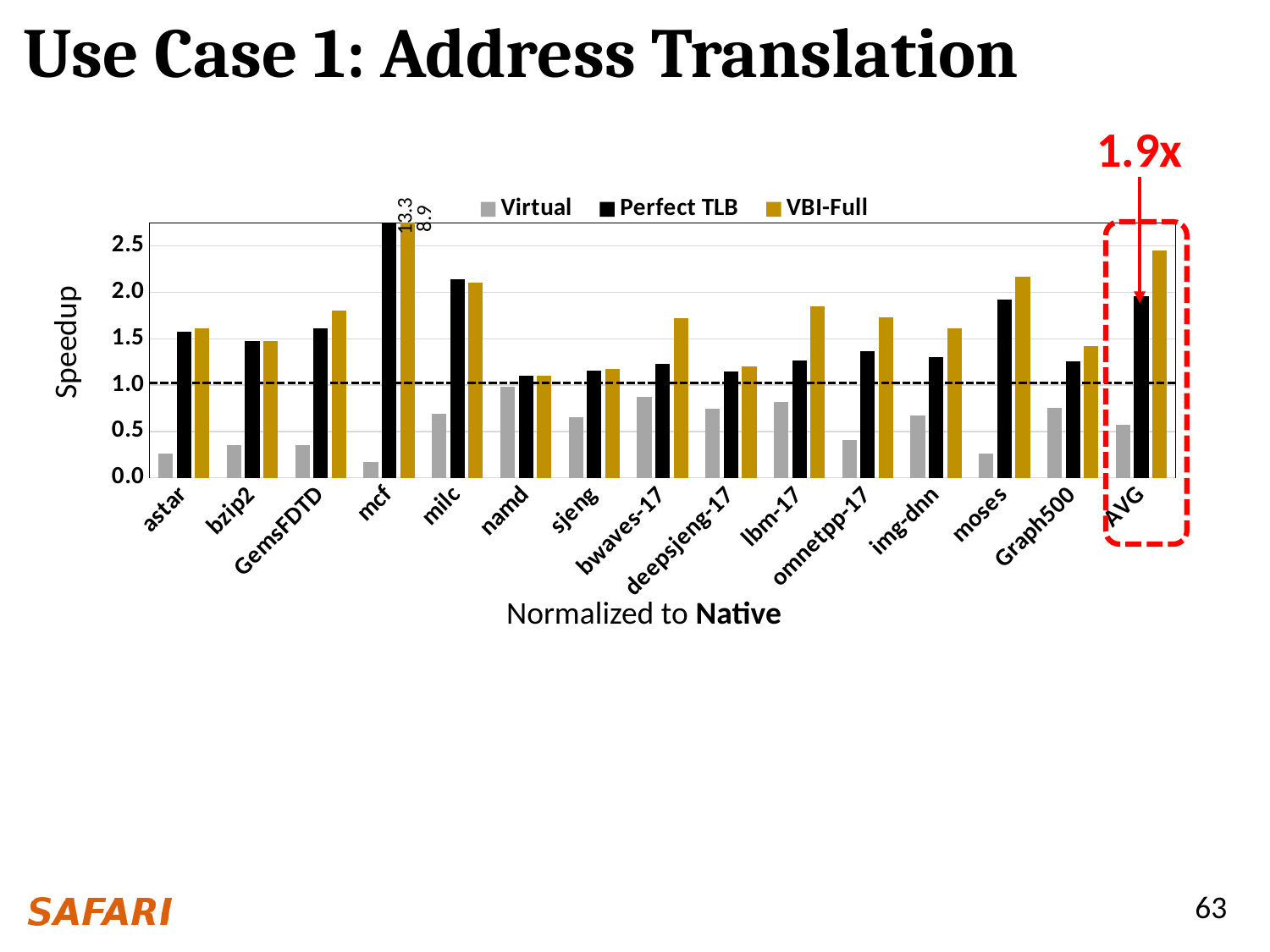
Which benchmark has the highest Perfect TLB speedup? mcf Is the VBI-Full speedup for moses greater or less than 2.0? greater How many categories (benchmarks) are shown along the x axis, including AVG? 15 What is the Perfect TLB speedup for mcf? 8.9 What is the VBI-Full speedup for mcf? 13.3 For bwaves-17, which is larger: the Perfect TLB speedup or the VBI-Full speedup? VBI-Full What annotation is shown above the AVG group on the chart? 1.9x How many series does the legend list? 3 What kind of chart is shown on the slide? Bar chart Is the Virtual speedup for astar greater or less than 0.5? less What is the label of the y axis? Speedup What is the difference between the Perfect TLB and VBI-Full speedups for mcf? 4.4